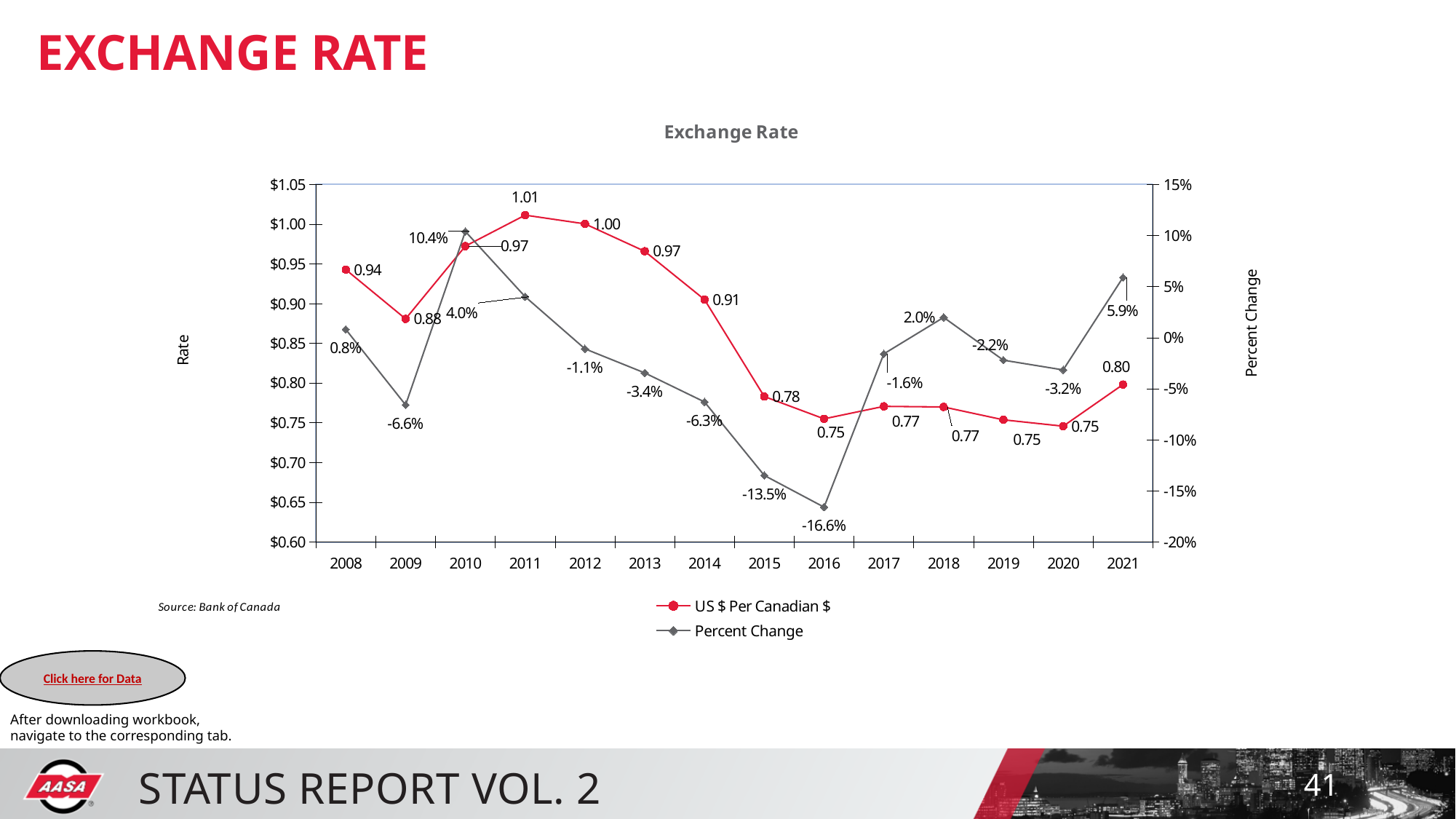
What was the Percent Change in 2016? -16.6% What is the difference between the US $ Per Canadian $ rate in 2011 and in 2016? 0.26 What kind of chart is shown? Line chart What was the US $ Per Canadian $ rate in 2021? 0.80 In which year was the Percent Change lowest? 2016 What was the US $ Per Canadian $ rate in 2011? 1.01 Which year had a higher US $ Per Canadian $ rate, 2008 or 2014? 2008 Did the US $ Per Canadian $ rate rise or fall from 2011 to 2016? Fall In which year was the US $ Per Canadian $ rate highest? 2011 In which year was the Percent Change highest? 2010 How many years are shown on the x axis? 14 How many series does the legend list? 2